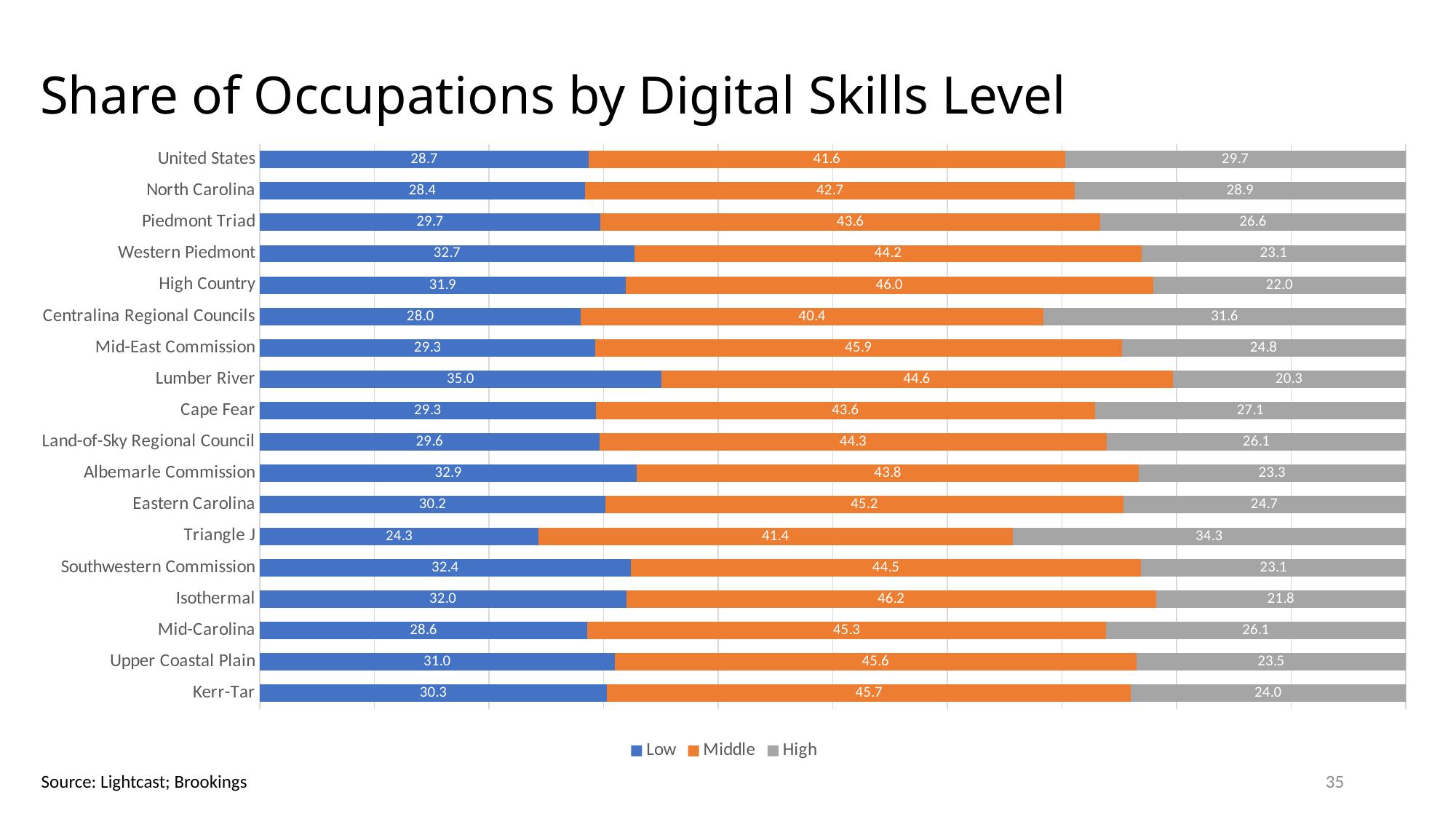
Which region has the highest High share? Triangle J What is the difference between the Middle and Low shares for the United States? 12.9 What is the Low share for Lumber River? 35.0 Which region has the lowest Middle share? Centralina Regional Councils What is the Middle share for North Carolina? 42.7 What is the High share for Centralina Regional Councils? 31.6 What kind of chart is shown on the slide? Stacked bar chart Which region has the lowest Low share? Triangle J How many regions are shown on the chart? 18 What is the total of the stacked bar for Triangle J? 100.0 How many series does the legend list? 3 Which is larger, the High share for Piedmont Triad or the High share for Western Piedmont? Piedmont Triad